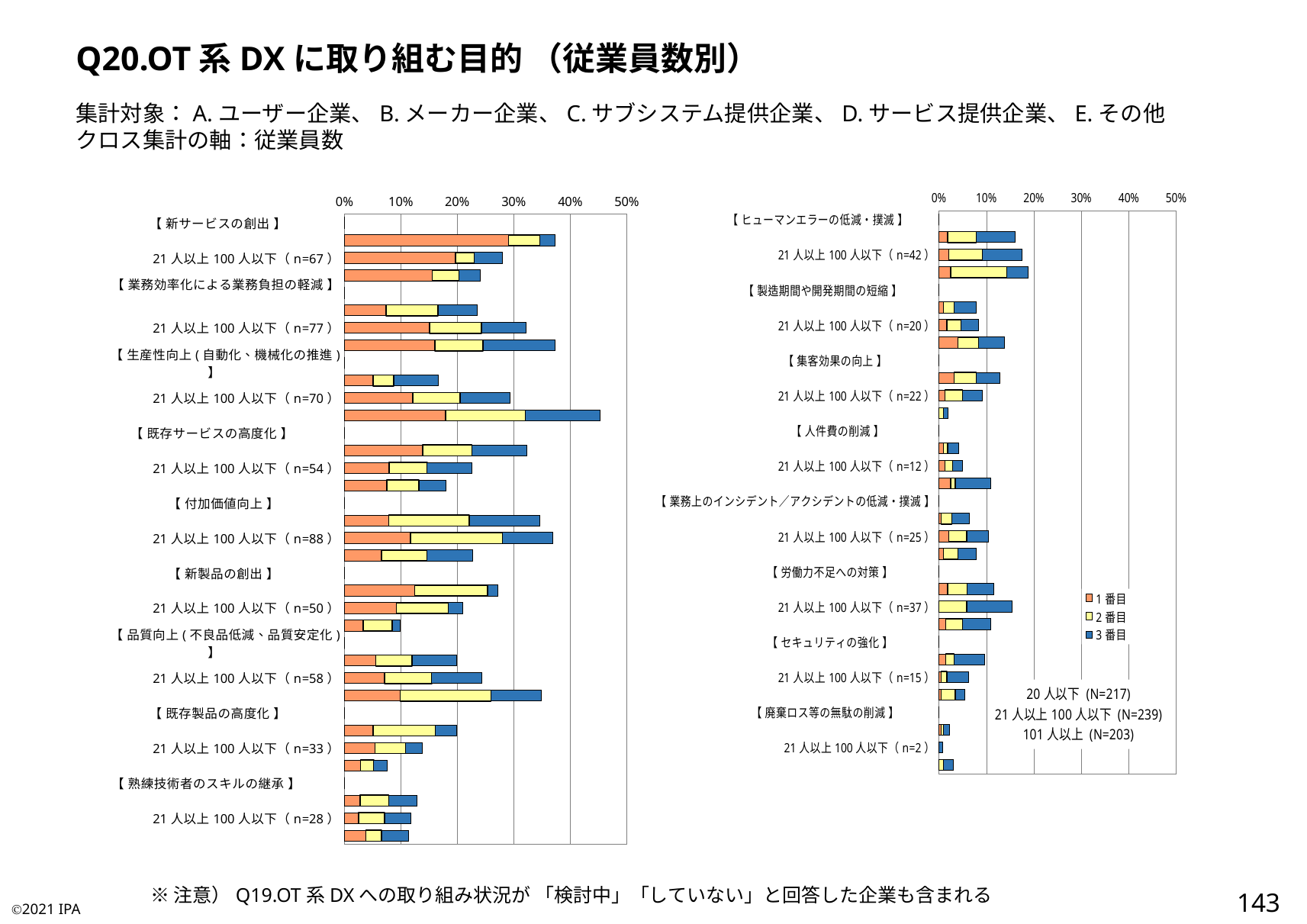
How many purpose categories (bracketed headings) are shown in the left chart? 9 In the left chart, which employee-size group has the longest total bar under 【新サービスの創出】: 20人以下 or 101人以上? 20人以下 In the left chart, is the total bar for 101人以上 under 【生産性向上(自動化、機械化の推進)】 greater or less than 40%? greater According to the note on the right chart, what is the N for the 20人以下 group? N=217 What kind of chart is the left chart on the slide? Stacked bar chart How many purpose categories (bracketed headings) are shown in the right chart? 8 In the right chart, is the total bar for 21人以上100人以下 (n=2) under 【廃棄ロス等の無駄の削減】 greater or less than 10%? less In the left chart, which category and group has the longest total bar overall? 【生産性向上(自動化、機械化の推進)】, 101人以上 In the left chart, is the total bar for 20人以下 under 【新サービスの創出】 greater or less than 30%? greater How many series does the legend on the right chart list? 3 What are the legend entries shown on the right chart? 1番目, 2番目, 3番目